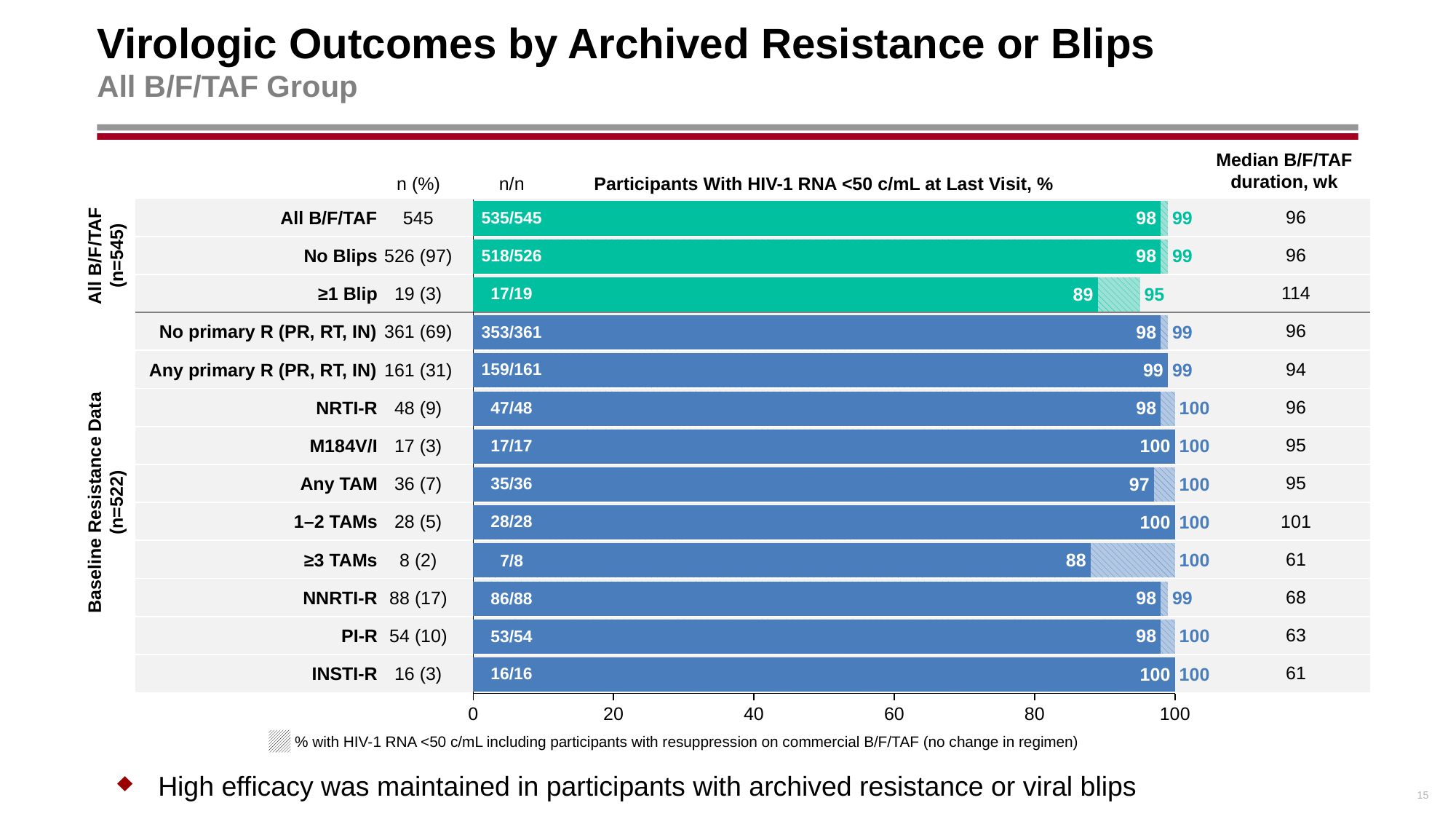
What does the hatched pattern in the chart represent, according to the legend? % with HIV-1 RNA <50 c/mL including participants with resuppression on commercial B/F/TAF (no change in regimen) What is the difference between the hatched (including resuppression) value and the solid bar value for the ≥3 TAMs group? 12 How many categories (rows) are plotted in the chart? 13 What is the n/n label shown for the ≥3 TAMs bar? 7/8 What is the solid bar value for the Any TAM group? 97 What kind of chart is shown on the slide? bar chart What is the value including participants with resuppression (hatched bar) for the NRTI-R group? 100 Which has a higher solid bar value: Any primary R (PR, RT, IN) or No primary R (PR, RT, IN)? Any primary R (PR, RT, IN) What percentage of participants in the ≥1 Blip group had HIV-1 RNA <50 c/mL at last visit (solid bar value)? 89 What is the difference between the hatched (including resuppression) value and the solid bar value for the ≥1 Blip group? 6 Which category has the lowest solid bar value for participants with HIV-1 RNA <50 c/mL at last visit? ≥3 TAMs Is the solid bar value for the ≥3 TAMs group greater or less than 90? less